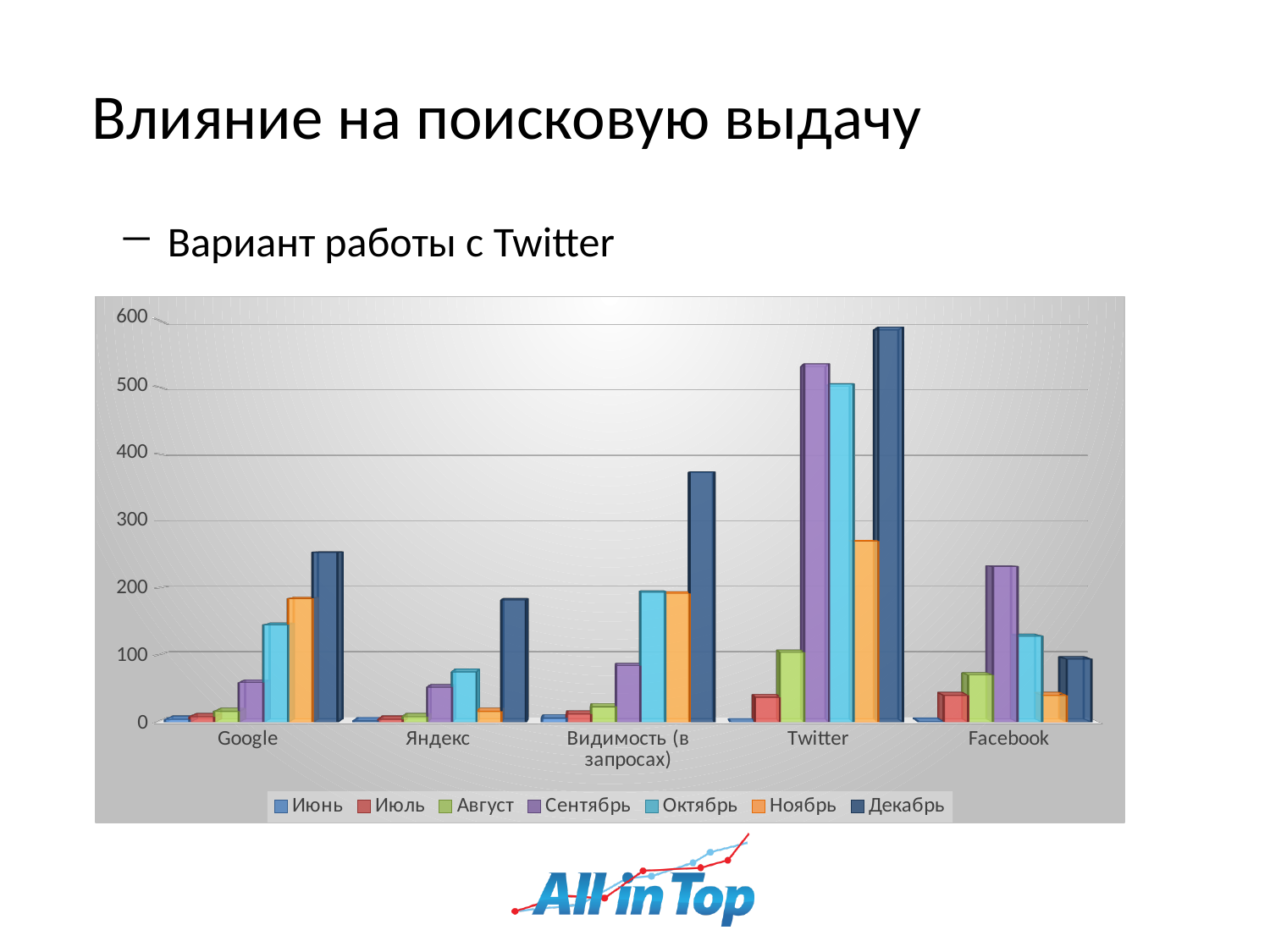
Which is larger: the Декабрь value for Google or the Декабрь value for Яндекс? Google In the Google category, do the values rise or fall from Июнь to Декабрь? rise Which series has the highest value in the Facebook category? Сентябрь Is the value for Сентябрь in the Facebook category greater or less than 200? greater How many series does the chart legend list? 7 Is the value for Декабрь in the Видимость (в запросах) category greater or less than 400? less Which category has the highest Декабрь bar? Twitter Is the value for Декабрь in the Google category greater or less than 200? greater Which series does the legend list first? Июнь How many categories are shown on the x axis of the chart? 5 What kind of chart is shown on the slide? bar chart